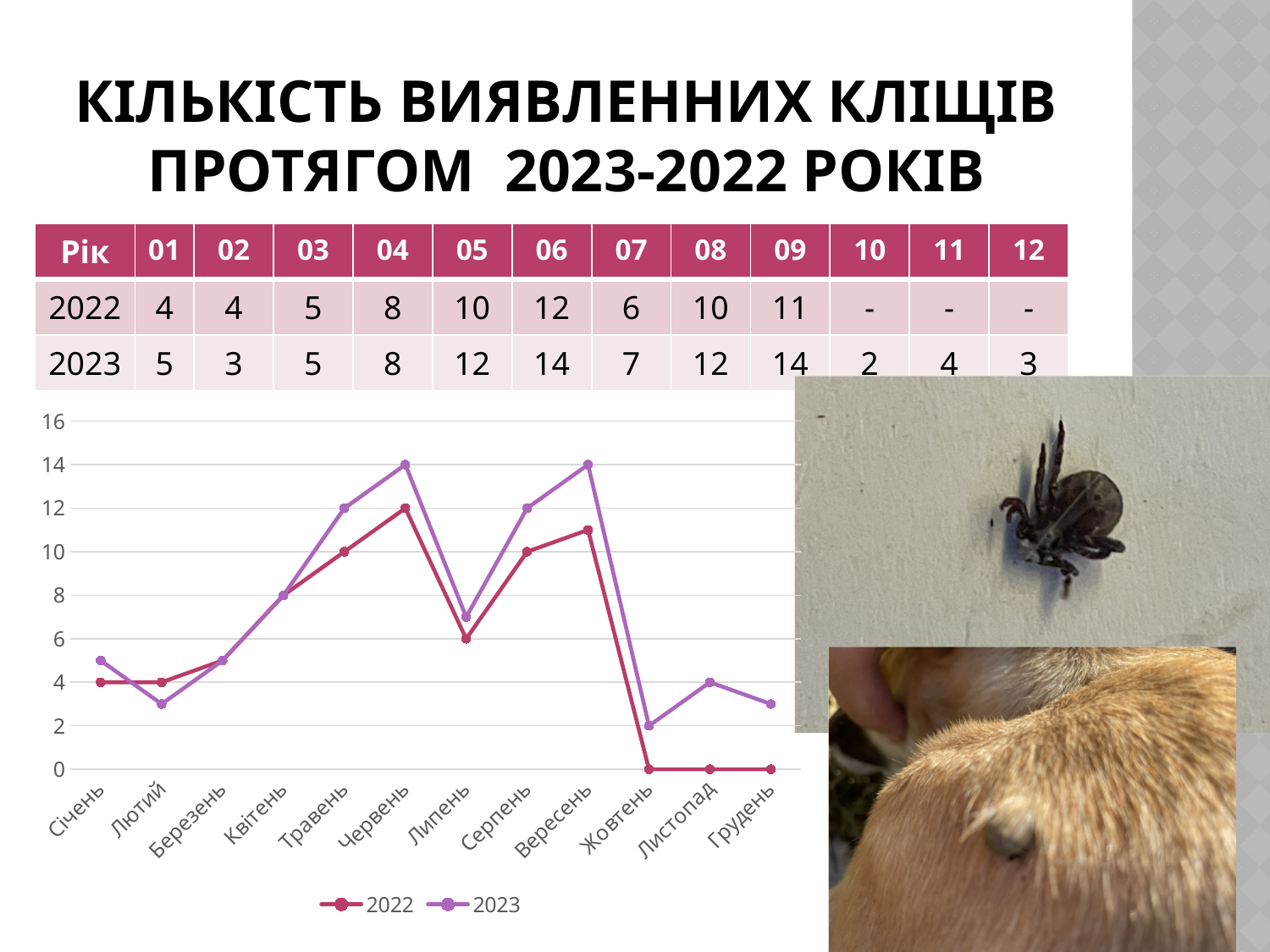
Which series is drawn in purple in the chart? 2023 How many series does the chart legend list? 2 In which month does the 2022 series reach its highest value? Червень In Лютий, which series has the larger value, 2022 or 2023? 2022 What kind of chart is shown on the slide? line chart Does the 2023 series rise or fall from Вересень to Жовтень? fall In which month does the 2023 series have its lowest value? Жовтень How many months are plotted along the x axis of the chart? 12 Is the value for 2023 in Травень greater or less than 10? greater What is the value for 2022 in Вересень? 11 What is the difference between the 2023 and 2022 values in Червень? 2 What is the value for 2023 in Червень? 14